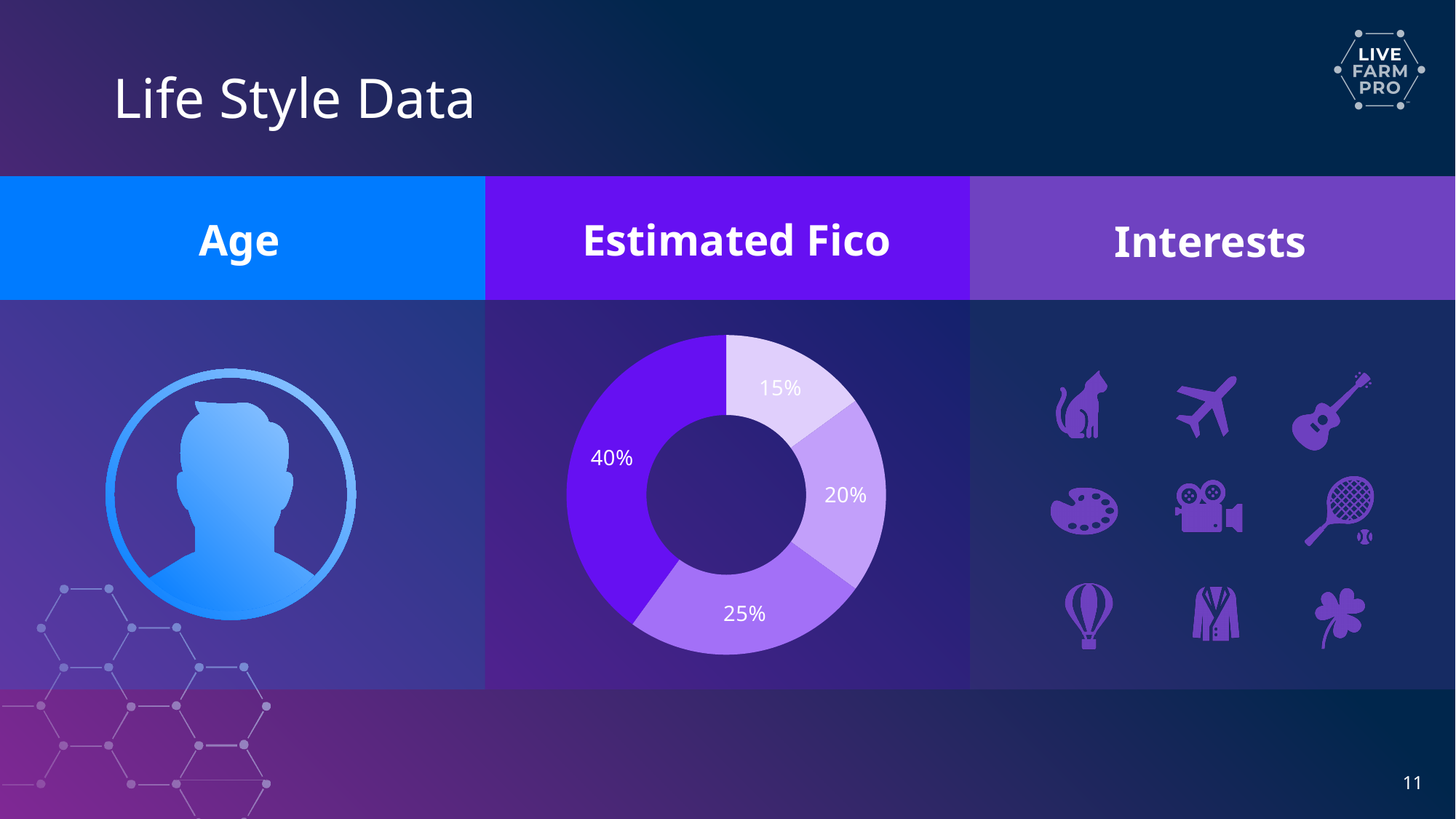
What combined share of the Estimated Fico donut chart do the two smallest slices make up? 35% Which column heading sits above the donut chart on the slide? Estimated Fico In the Estimated Fico donut chart, which is larger: the slice on the left side or the slice at the bottom? the slice on the left (40%) In the Estimated Fico donut chart, what is the difference between the largest slice and the smallest slice? 25 percentage points What kind of chart is shown under the "Estimated Fico" heading? donut (pie) chart How many slices does the Estimated Fico donut chart have? 4 What is the value of the smallest slice in the Estimated Fico donut chart? 15% What is the value of the largest slice in the Estimated Fico donut chart? 40% What do the four slices of the Estimated Fico donut chart add up to? 100% What is the value of the lightest-coloured slice in the Estimated Fico donut chart? 15% What is the value of the slice at the bottom of the Estimated Fico donut chart? 25% In the Estimated Fico donut chart, what is the difference between the 25% slice and the 20% slice? 5 percentage points